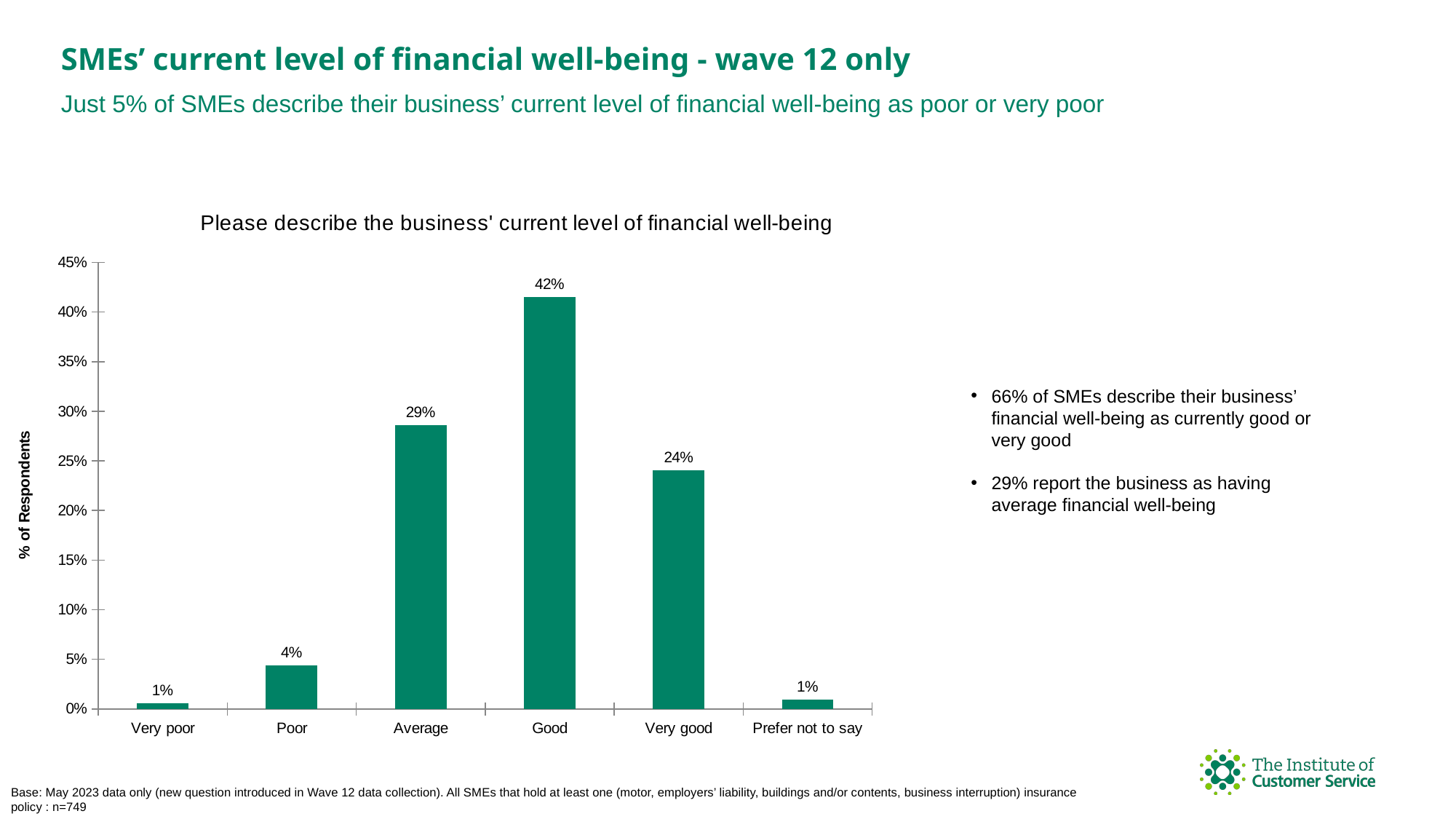
What kind of chart is shown on the slide? Bar chart What is the label on the vertical axis of the chart? % of Respondents Which is larger, the value for Average or the value for Very good? Average Which category has the highest value? Good What is the value shown for Poor? 4% What is the difference between the Good and Very good values? 18% What is the value for the Average category? 29% What percentage of respondents chose Very good? 24% How many categories are shown on the x axis? 6 What is the difference between the Average and Poor values? 25% What percentage of respondents described their business' financial well-being as Good? 42% Is the value for Good greater or less than 40%? greater